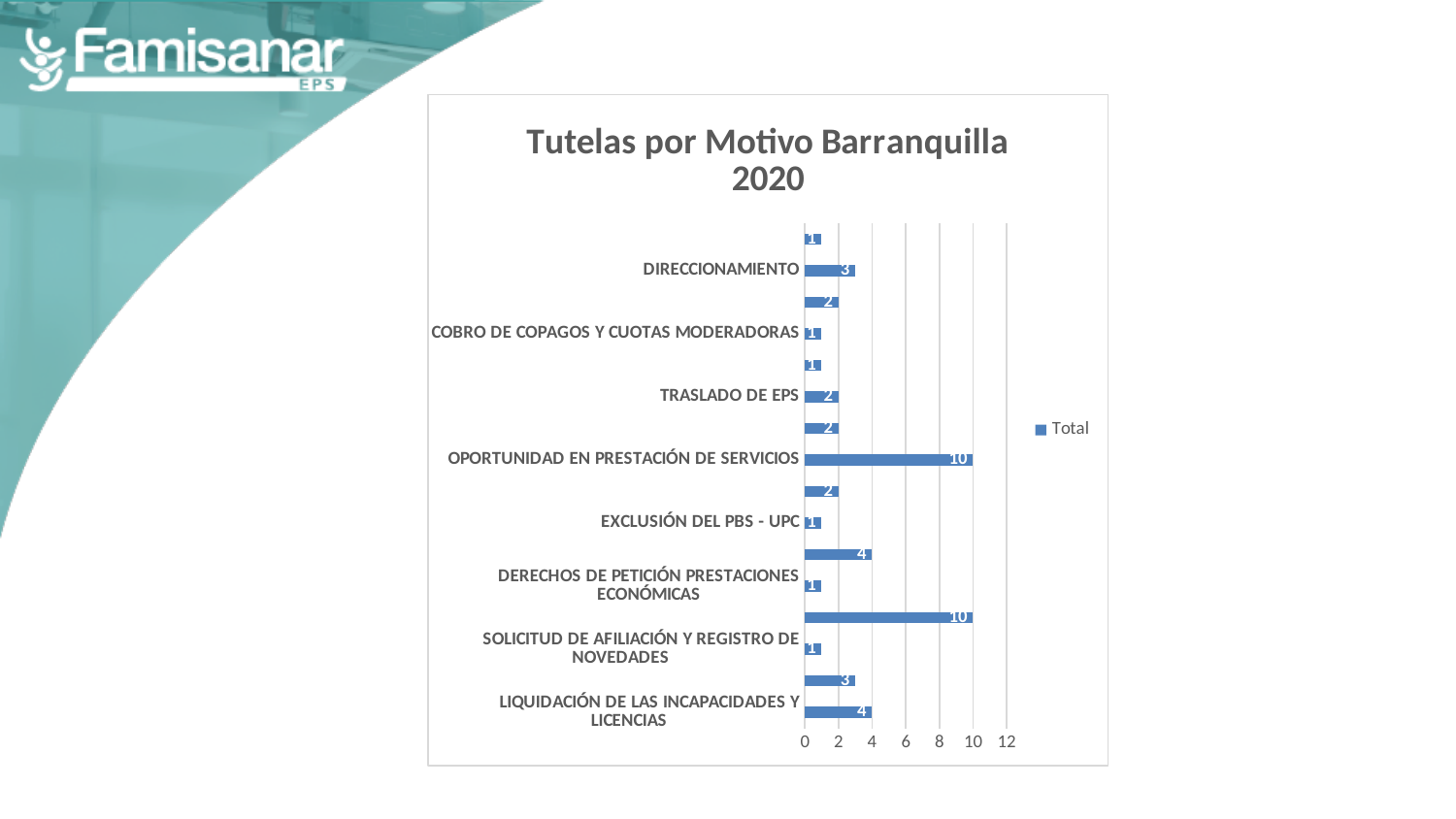
What is the value for EXCLUSIÓN DEL PBS - UPC? 1 Which has a larger value, DIRECCIONAMIENTO or TRASLADO DE EPS? DIRECCIONAMIENTO What is the value for DIRECCIONAMIENTO? 3 How many bars are plotted in the chart? 16 What is the value for OPORTUNIDAD EN PRESTACIÓN DE SERVICIOS? 10 What is the title of the chart? Tutelas por Motivo Barranquilla 2020 How many series does the legend list? 1 What kind of chart is shown on the slide? Bar chart What is the value for TRASLADO DE EPS? 2 What is the difference between the values for OPORTUNIDAD EN PRESTACIÓN DE SERVICIOS and LIQUIDACIÓN DE LAS INCAPACIDADES Y LICENCIAS? 6 What is the value for COBRO DE COPAGOS Y CUOTAS MODERADORAS? 1 What is the value for LIQUIDACIÓN DE LAS INCAPACIDADES Y LICENCIAS? 4